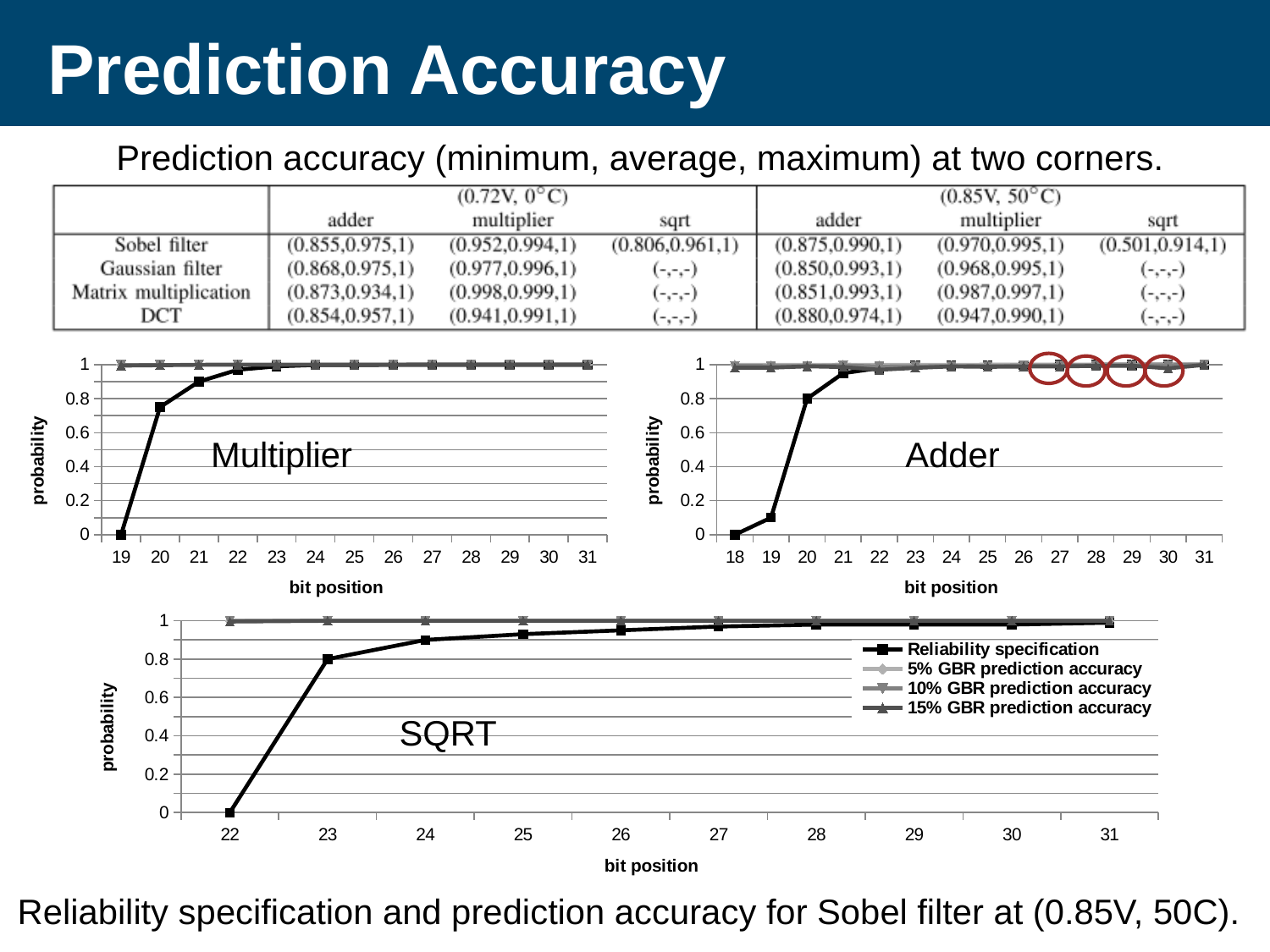
In the SQRT chart, what is the Reliability specification probability at bit position 23? 0.8 What kind of chart is the Multiplier chart? line chart In the Adder chart, is the Reliability specification value at bit position 19 greater or less than 0.2? less How many bit positions are shown on the x axis of the SQRT chart? 10 How many series does the legend on the SQRT chart list? 4 In the SQRT chart, at which bit position is the Reliability specification lowest? 22 In the Multiplier chart, is the Reliability specification value at bit position 20 greater or less than 0.6? greater In the Multiplier chart, what is the Reliability specification probability at bit position 19? 0 In the Adder chart, what is the Reliability specification probability at bit position 20? 0.8 In the SQRT chart, does the Reliability specification series rise or fall as bit position increases? rise How many bit positions are shown on the x axis of the Adder chart? 14 In the Adder chart, what is the Reliability specification probability at bit position 18? 0